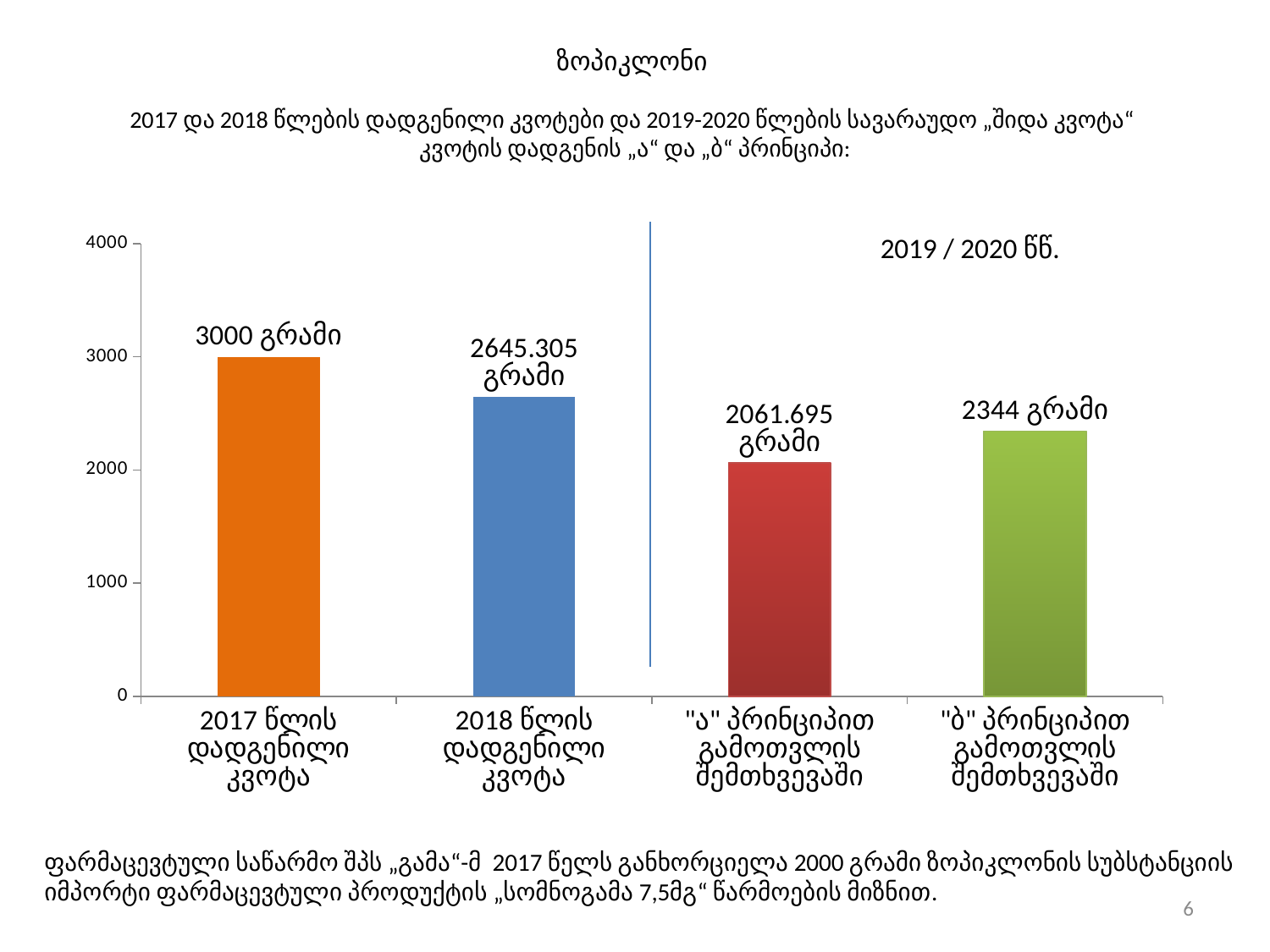
What is the difference between the 2017 quota (3000 გრამი) and the 2018 quota (2645.305 გრამი)? 354.695 გრამი What kind of chart is shown on the slide? Bar chart What is the value for the 2017 წლის დადგენილი კვოტა bar? 3000 გრამი What is the title at the top of the slide? ზოპიკლონი Which category has the lowest value? "ა" პრინციპით გამოთვლის შემთხვევაში What is the value shown for "ბ" პრინციპით გამოთვლის შემთხვევაში? 2344 გრამი What is the difference between the "ბ" principle value and the "ა" principle value? 282.305 გრამი What is the value shown for "ა" პრინციპით გამოთვლის შემთხვევაში? 2061.695 გრამი What is the value for the 2018 წლის დადგენილი კვოტა bar? 2645.305 გრამი Which is larger: the value for the "ა" principle or the value for the "ბ" principle? "ბ" პრინციპით გამოთვლის შემთხვევაში Which category has the highest value? 2017 წლის დადგენილი კვოტა How many bars are plotted in the chart? 4